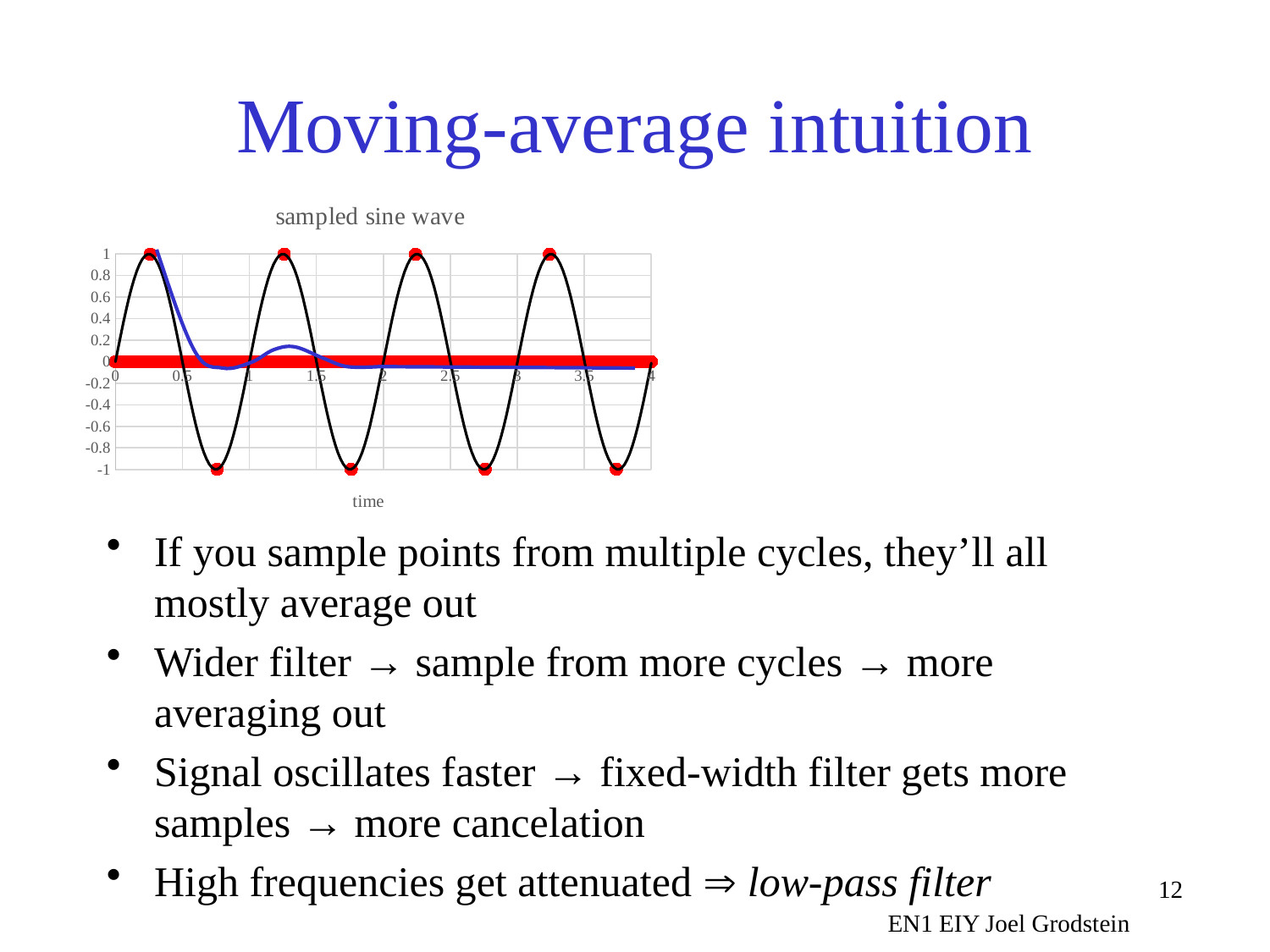
How many troughs at the value -1 does the black sine wave have within the plotted time range? 4 What is the label of the x axis of the chart? time What is the largest value shown on the x axis? 4 What is the title of the chart? sampled sine wave What is the highest value reached by the black sine wave? 1 Which is larger, the value of the black sine wave at time 0.25 or at time 0.75? time 0.25 What kind of chart is shown on the slide? line chart How many peaks at the value 1 does the black sine wave have within the plotted time range? 4 What is the lowest value reached by the black sine wave? -1 Is the value of the blue curve at time 0.5 greater or less than 0.6? less Does the blue curve rise or fall as time goes from 0 to 0.5? fall Is the value of the blue curve at time 3 greater or less than 0.4? less